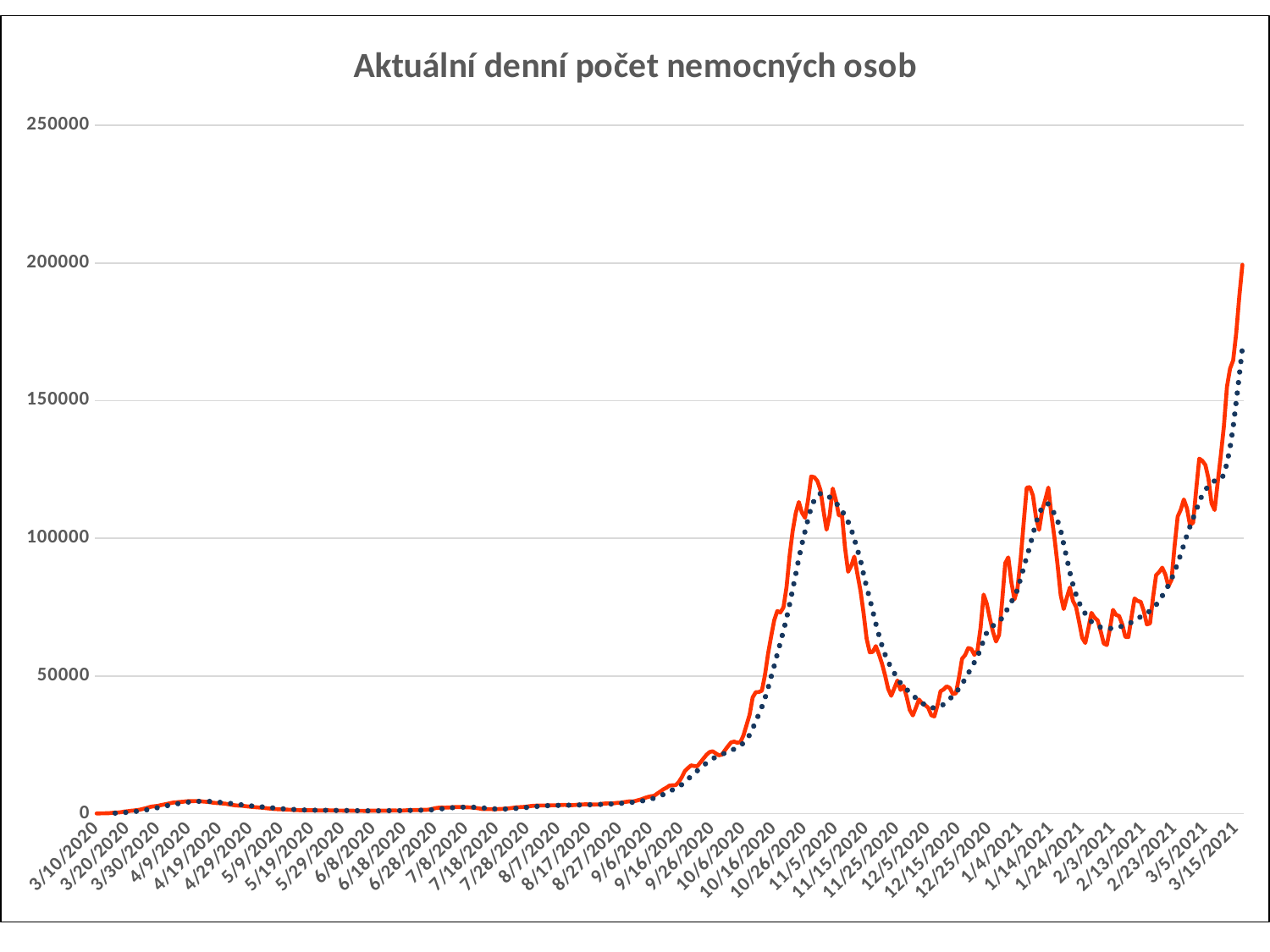
Is the value of the red line at 1/14/2021 greater or less than 100000? greater Which is higher on the red line: the value at 10/26/2020 or the value at 3/15/2021? 3/15/2021 How many lines are plotted on the chart? 2 Is the value of the red line at 7/8/2020 greater or less than 50000? less Is the value of the red line at 10/26/2020 greater or less than 100000? greater What kind of chart is shown on the slide? line chart What is the title of the chart? Aktuální denní počet nemocných osob What is the highest value shown on the vertical axis? 250000 Does the red line rise or fall between 10/26/2020 and 12/5/2020? fall Does the red line rise or fall between 2/3/2021 and 3/15/2021? rise